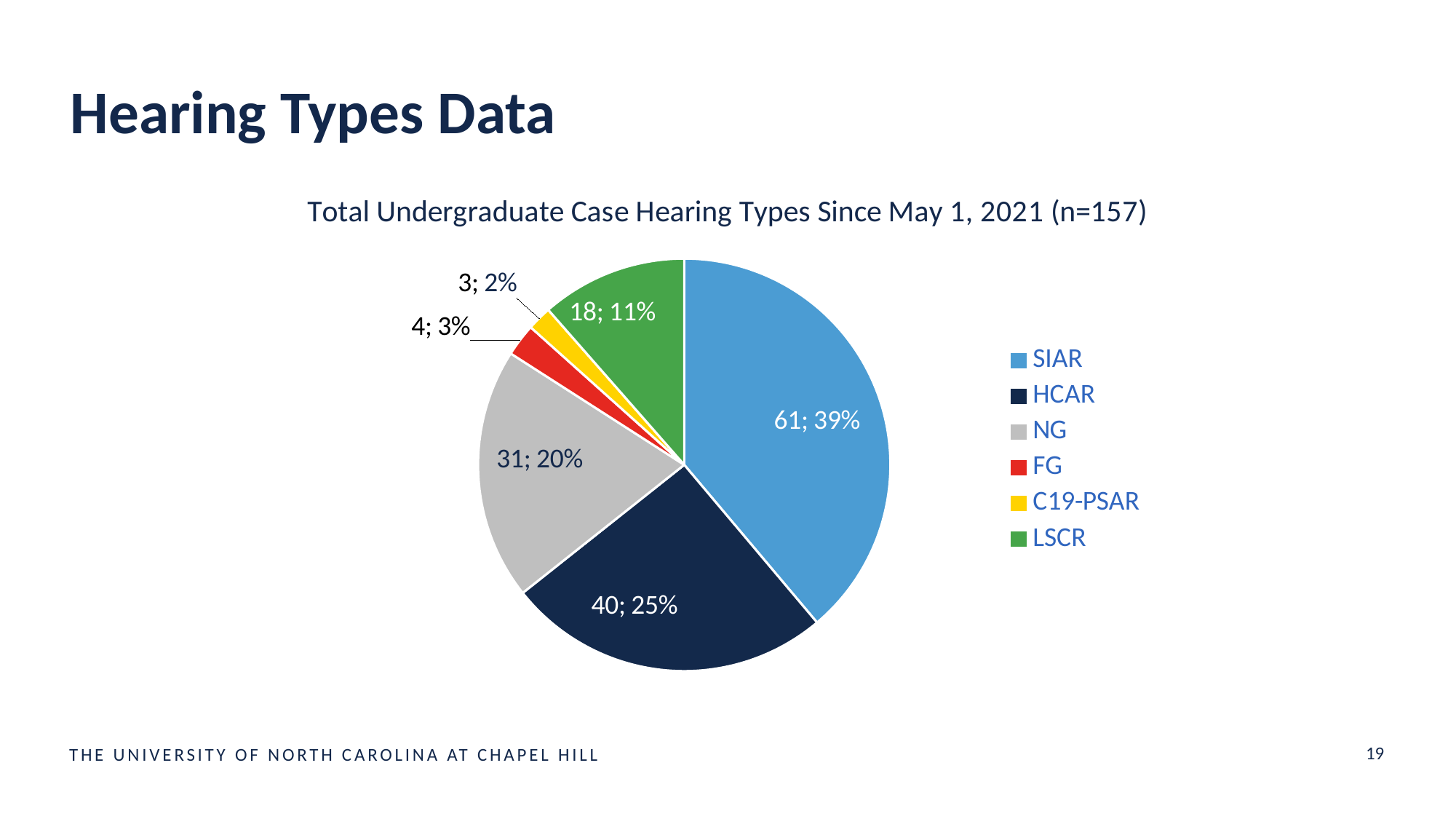
How many cases are in the NG slice? 31 What colour is the LSCR slice? Green What is the title of the chart? Total Undergraduate Case Hearing Types Since May 1, 2021 (n=157) How many cases are in the SIAR slice? 61 What type of chart is shown on the slide? Pie chart What percentage of cases does the HCAR slice represent? 25% Which has more cases, FG or C19-PSAR? FG What share of the pie does LSCR represent? 11% How many hearing types does the legend list? 6 How many more cases are in the SIAR slice than in the HCAR slice? 21 Which hearing type has the largest slice? SIAR Which hearing type has the smallest slice? C19-PSAR